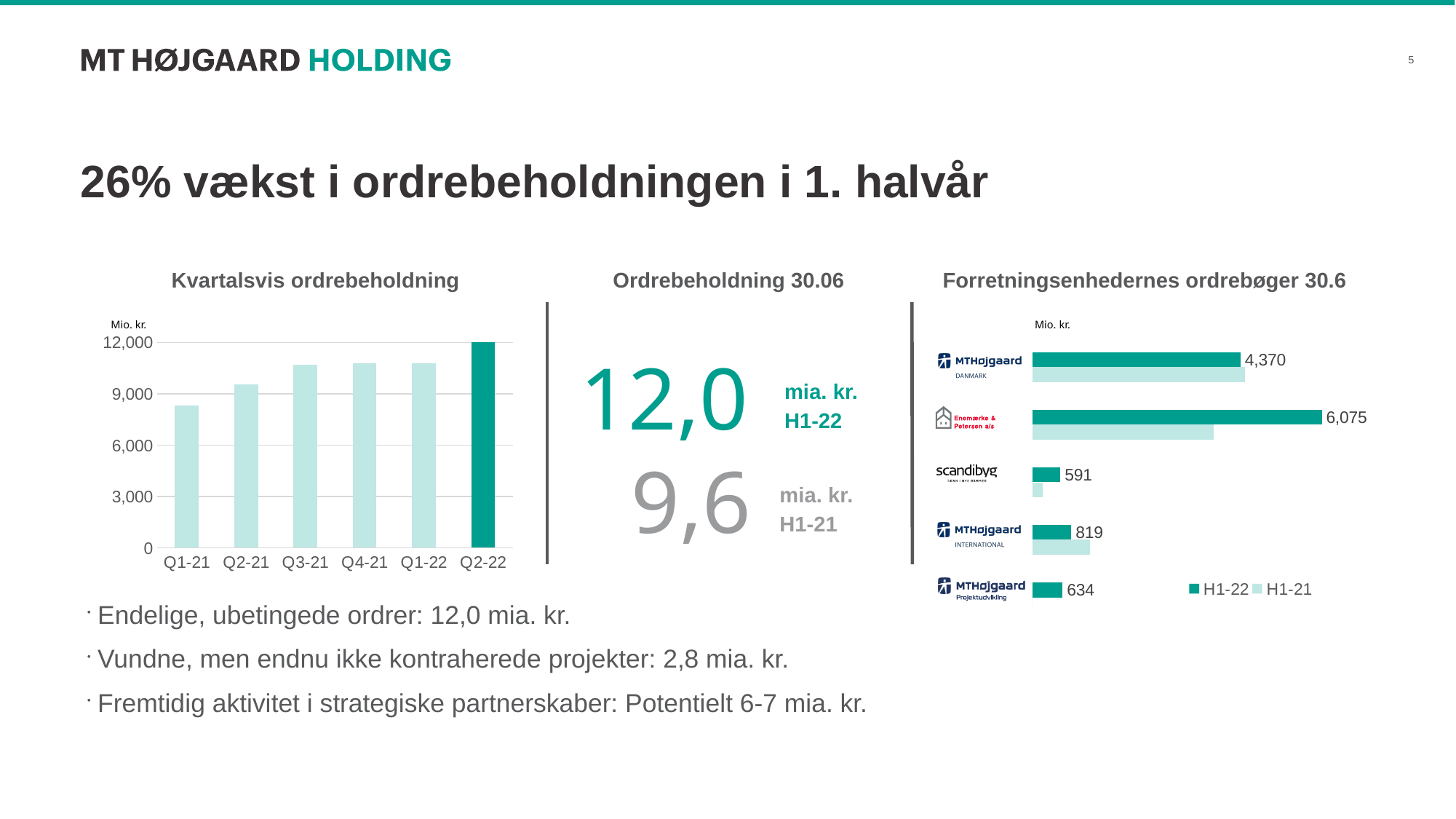
In the 'Forretningsenhedernes ordrebøger 30.6' chart, what is the H1-22 value for Enemærke & Petersen? 6,075 In the 'Kvartalsvis ordrebeholdning' chart, is the value for Q1-21 greater or less than 9,000? less In the 'Kvartalsvis ordrebeholdning' chart, which quarter has the lowest order backlog? Q1-21 In the 'Kvartalsvis ordrebeholdning' chart, do the values generally rise or fall from Q1-21 to Q2-22? rise What kind of chart is the 'Kvartalsvis ordrebeholdning' chart? Bar chart In the 'Kvartalsvis ordrebeholdning' chart, which quarter has the highest order backlog? Q2-22 In the 'Forretningsenhedernes ordrebøger 30.6' chart, what is the H1-22 value for MT Højgaard Danmark? 4,370 How many series does the legend of the 'Forretningsenhedernes ordrebøger 30.6' chart list? 2 In the 'Forretningsenhedernes ordrebøger 30.6' chart, what is the difference between the H1-22 values for Enemærke & Petersen and MT Højgaard Danmark? 1,705 In the 'Kvartalsvis ordrebeholdning' chart, how many quarters are plotted? 6 In the 'Forretningsenhedernes ordrebøger 30.6' chart, which has the larger H1-22 value: MT Højgaard International or Scandibyg? MT Højgaard International In the 'Forretningsenhedernes ordrebøger 30.6' chart, which business unit has the lowest H1-22 value? Scandibyg